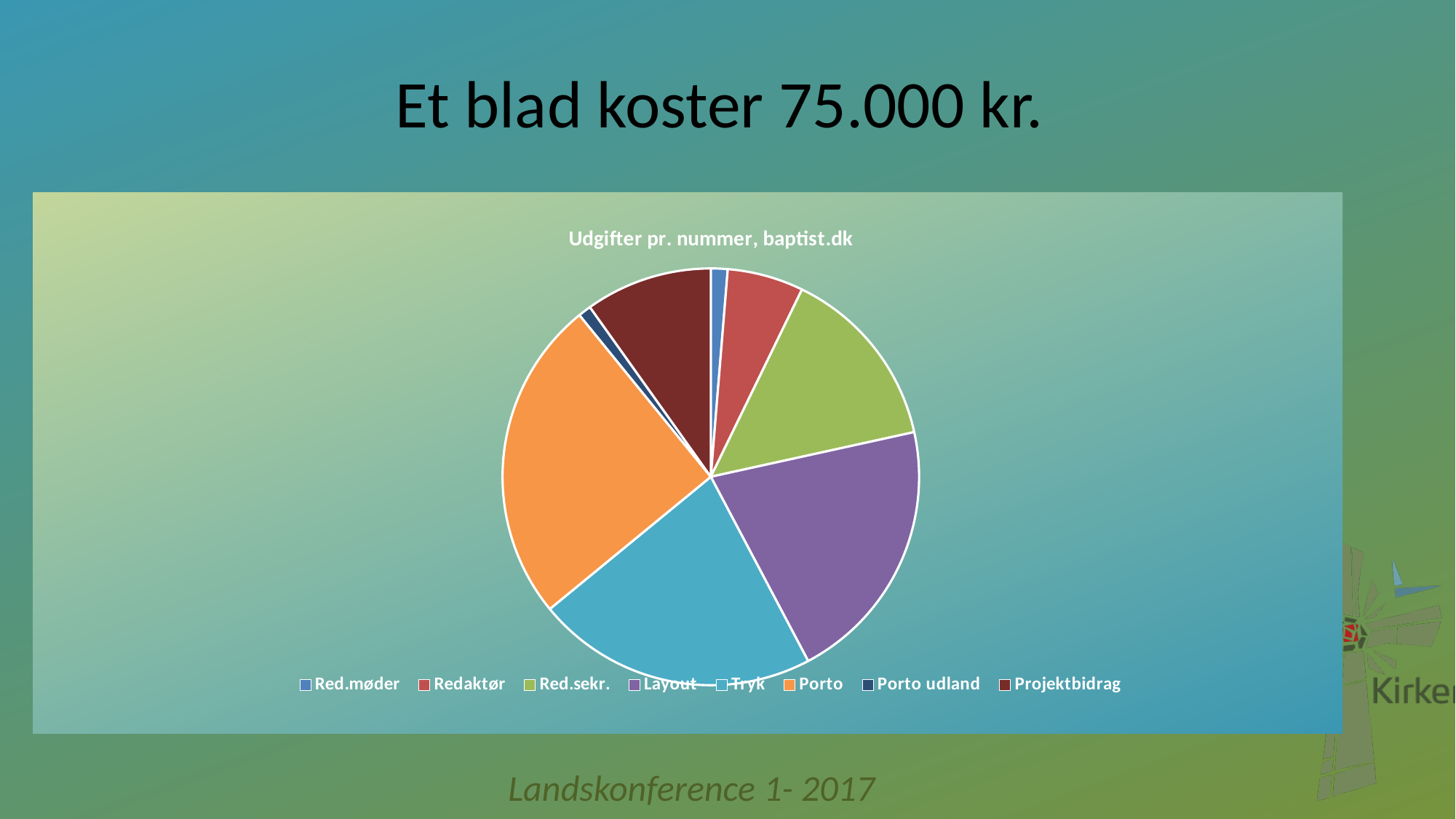
Which slice is larger, Porto or Red.sekr.? Porto What kind of chart is shown on the slide? pie chart Which category has the largest slice in the pie chart? Porto What colour is the Porto slice in the pie chart? orange How many categories does the legend of the pie chart list? 8 What is the title of the chart? Udgifter pr. nummer, baptist.dk Which slice is larger, Layout or Redaktør? Layout Which category is listed first in the legend? Red.møder Which slice is larger, Tryk or Projektbidrag? Tryk